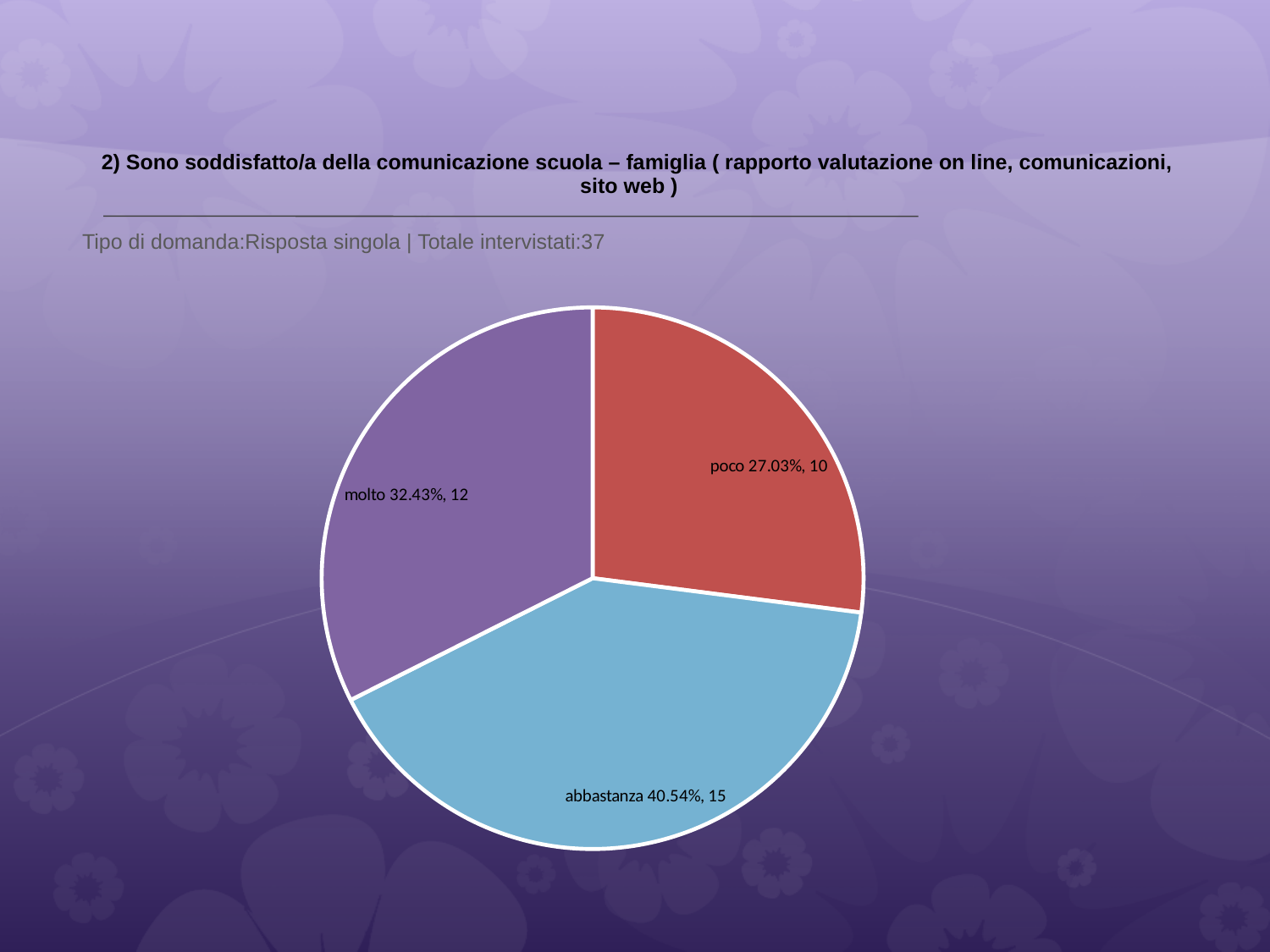
What percentage share does the 'molto' slice have? 32.43% How many respondents answered 'poco'? 10 What is the difference in respondent count between 'abbastanza' and 'poco'? 5 Which category has the smallest slice? poco What percentage share does the 'abbastanza' slice have? 40.54% Which category has the largest slice? abbastanza What kind of chart is shown on the slide? pie chart What colour is the 'abbastanza' slice? blue How many respondents answered 'molto'? 12 What percentage share does the 'poco' slice have? 27.03% Which has more respondents, 'molto' or 'poco'? molto How many slices does the pie chart have? 3